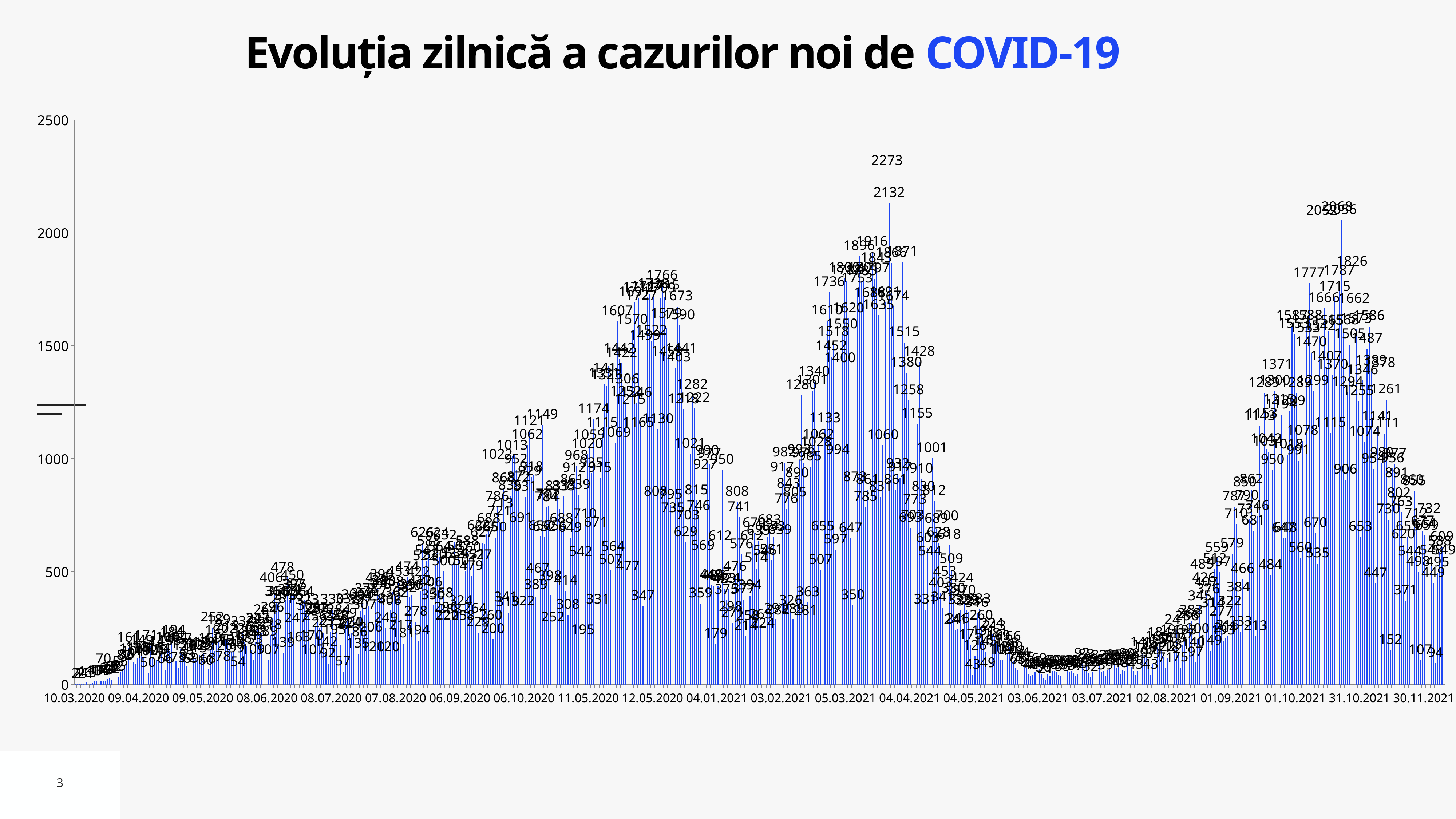
What is the difference between the two highest labelled values, 2273 and 2132? 141 What is the second-highest daily value labelled on the chart? 2132 What kind of chart is shown on the slide? bar chart Is the value at the 03.07.2021 tick greater or less than 500? less What is the title of the chart? Evoluția zilnică a cazurilor noi de COVID-19 Do the values generally rise or fall between 02.08.2021 and 01.10.2021? rise Is the tallest bar on the chart greater or less than 2000? greater Do the values generally rise or fall between 04.04.2021 and 03.06.2021? fall What is the highest value shown on the vertical axis? 2500 Is the value at the 03.06.2021 tick greater or less than 500? less What is the first date label on the horizontal axis? 10.03.2020 What is the highest daily value labelled on the chart? 2273